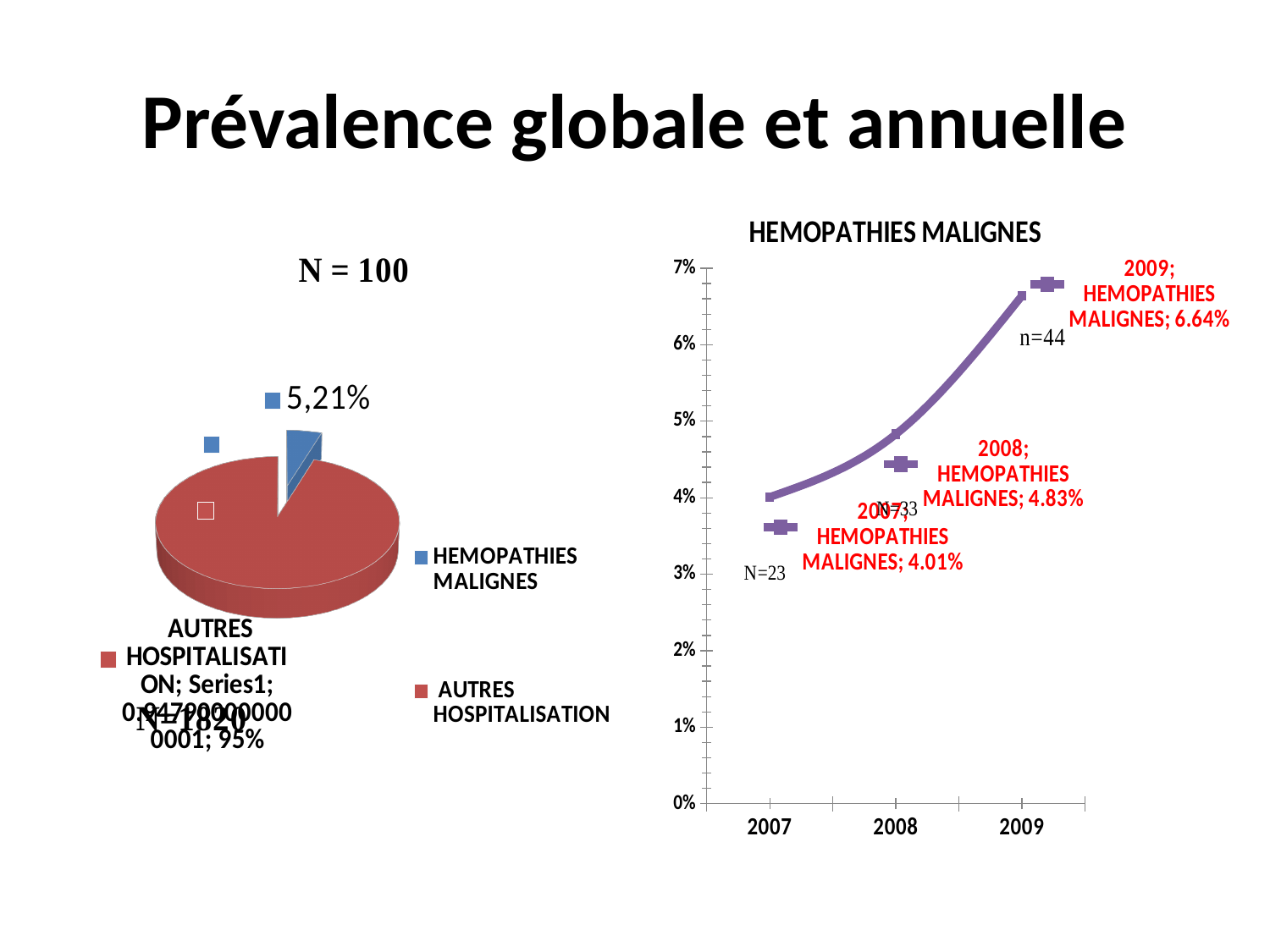
On the line chart titled HEMOPATHIES MALIGNES, what is the value for 2007? 4.01% On the line chart titled HEMOPATHIES MALIGNES, which year has the highest value? 2009 On the pie chart on the left, how many entries does the legend list? 2 On the line chart titled HEMOPATHIES MALIGNES, which year has the lowest value? 2007 On the line chart titled HEMOPATHIES MALIGNES, what is the difference between the 2009 and 2007 values? 2.63% On the line chart titled HEMOPATHIES MALIGNES, do the values rise or fall from 2007 to 2009? rise What kind of chart is the chart on the left of the slide? pie chart On the line chart titled HEMOPATHIES MALIGNES, what is the value for 2008? 4.83% On the line chart titled HEMOPATHIES MALIGNES, what is the value for 2009? 6.64% What kind of chart is the chart on the right of the slide? line chart On the pie chart on the left, what share is shown for HEMOPATHIES MALIGNES? 5,21% On the line chart titled HEMOPATHIES MALIGNES, how many years are plotted on the x axis? 3